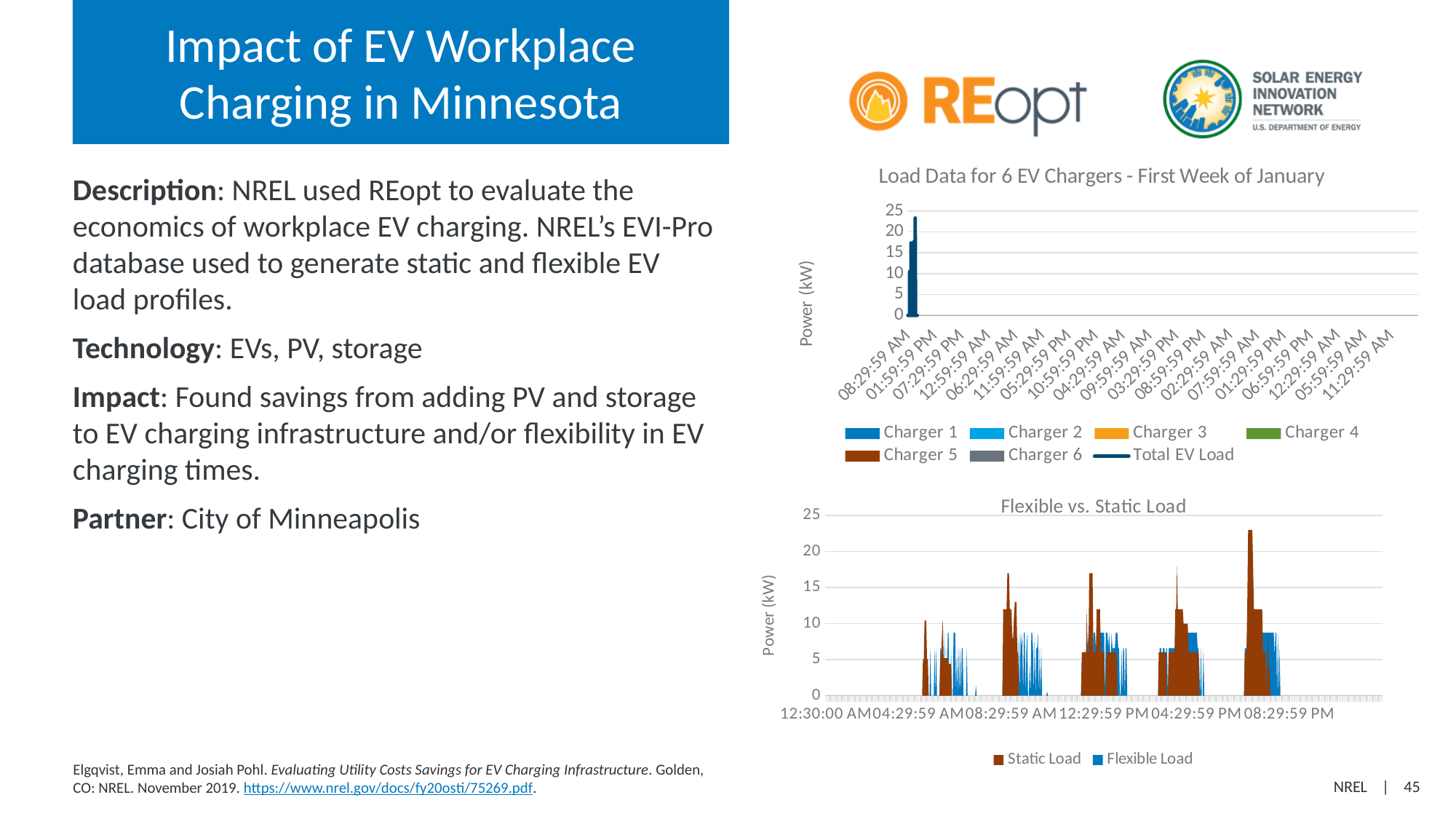
In the top chart, 'Load Data for 6 EV Chargers - First Week of January', what is the highest value shown on the y axis? 25 In the bottom chart, 'Flexible vs. Static Load', is the highest Static Load value greater or less than 20? greater In the bottom chart, 'Flexible vs. Static Load', what is the label of the y axis? Power (kW) In the bottom chart, 'Flexible vs. Static Load', which series reaches the higher peak value, Static Load or Flexible Load? Static Load What is the title of the top chart on the slide? Load Data for 6 EV Chargers - First Week of January In the top chart, 'Load Data for 6 EV Chargers - First Week of January', is the peak Total EV Load greater or less than 20? greater In the bottom chart, 'Flexible vs. Static Load', how many series does the legend list? 2 In the top chart, 'Load Data for 6 EV Chargers - First Week of January', how many series does the legend list? 7 In the bottom chart, 'Flexible vs. Static Load', is the highest Flexible Load value greater or less than 15? less